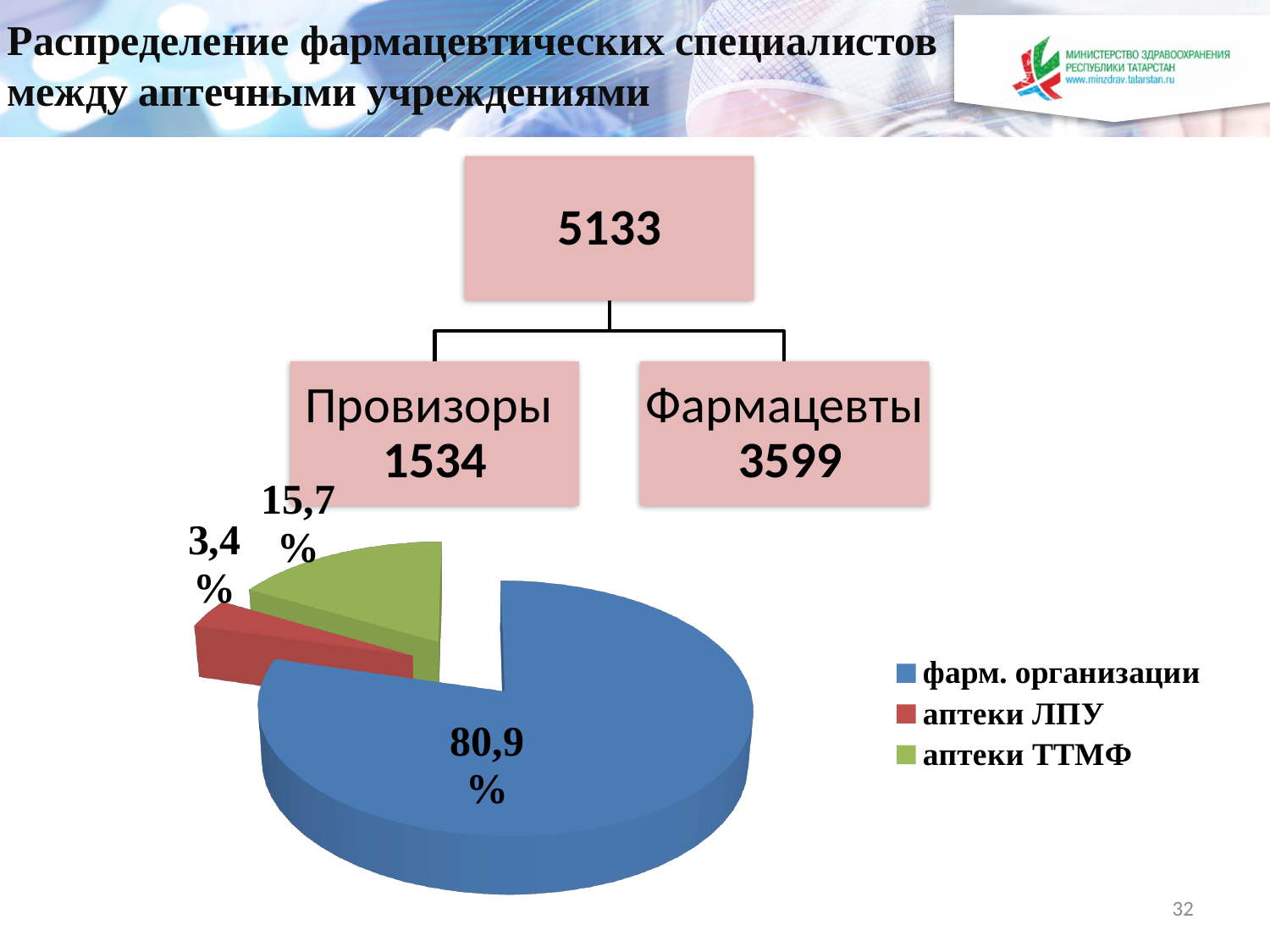
How many slices does the pie chart have? 3 What share of the pie chart does фарм. организации hold? 80,9% What type of chart is shown on the slide? pie chart What share of the pie chart does аптеки ЛПУ hold? 3,4% What colour is the аптеки ТТМФ slice in the pie chart? green Which category has the smallest slice in the pie chart? аптеки ЛПУ Which category has the largest slice in the pie chart? фарм. организации How many entries does the legend of the pie chart list? 3 By how many percentage points does the фарм. организации slice exceed the аптеки ТТМФ slice? 65,2 By how many percentage points does the аптеки ТТМФ slice exceed the аптеки ЛПУ slice? 12,3 Which slice is larger: аптеки ЛПУ or аптеки ТТМФ? аптеки ТТМФ What share of the pie chart does аптеки ТТМФ hold? 15,7%